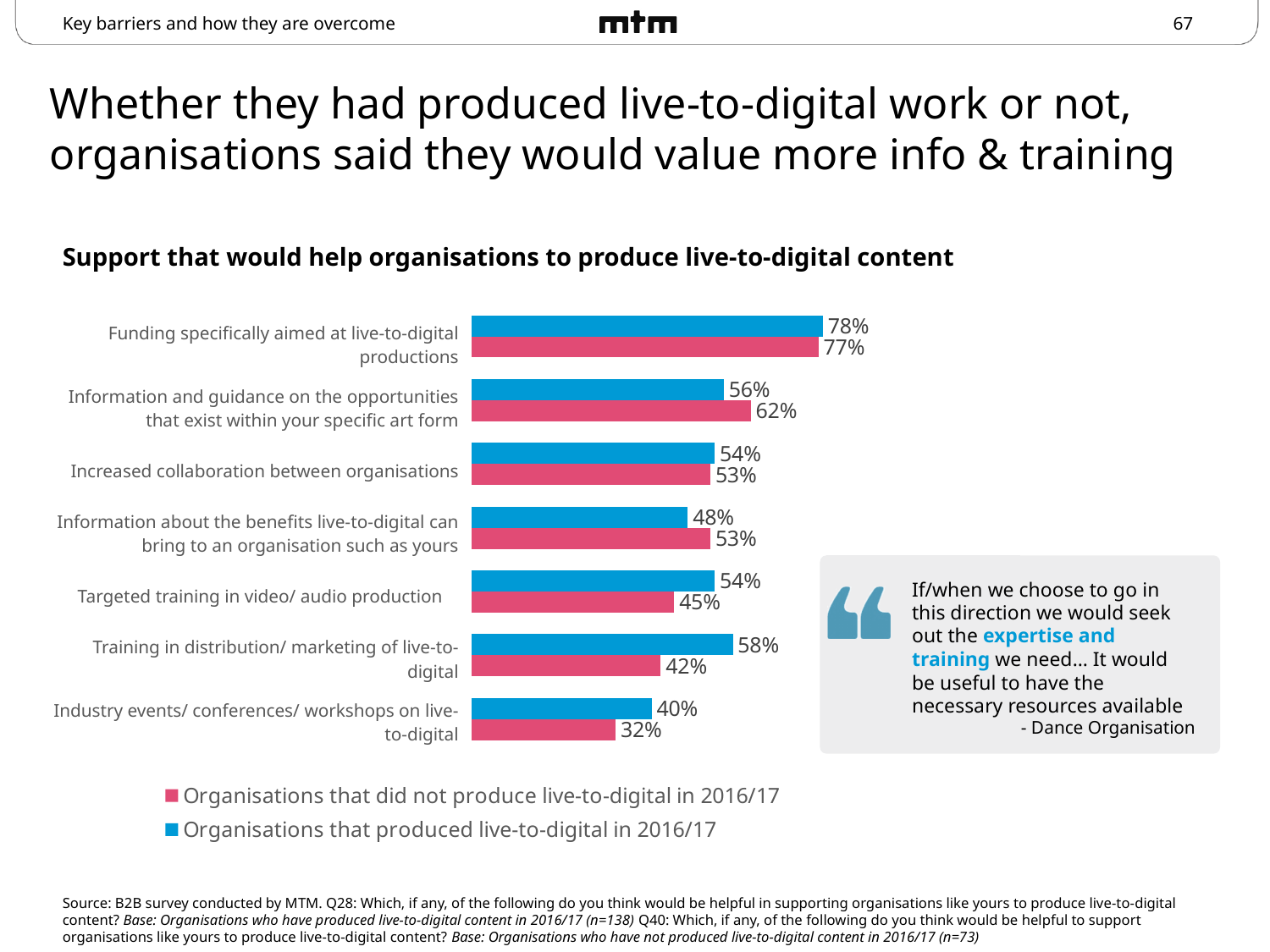
Which category has the lowest value for organisations that did not produce live-to-digital in 2016/17? Industry events/ conferences/ workshops on live-to-digital How many series does the legend list? 2 What is the value for 'Training in distribution/ marketing of live-to-digital' among organisations that did not produce live-to-digital in 2016/17? 42% What percentage of organisations that produced live-to-digital in 2016/17 selected 'Funding specifically aimed at live-to-digital productions'? 78% For 'Information about the benefits live-to-digital can bring to an organisation such as yours', which group has the larger value: organisations that produced live-to-digital or those that did not? Organisations that did not produce live-to-digital in 2016/17 What type of chart is shown on the slide? Bar chart How many support categories are shown in the chart? 7 What percentage of organisations that did not produce live-to-digital in 2016/17 selected 'Information and guidance on the opportunities that exist within your specific art form'? 62% Which colour represents organisations that produced live-to-digital in 2016/17? Blue What is the difference between the two series for 'Training in distribution/ marketing of live-to-digital'? 16 percentage points Which category has the highest value for organisations that produced live-to-digital in 2016/17? Funding specifically aimed at live-to-digital productions What is the difference between the two series for 'Industry events/ conferences/ workshops on live-to-digital'? 8 percentage points